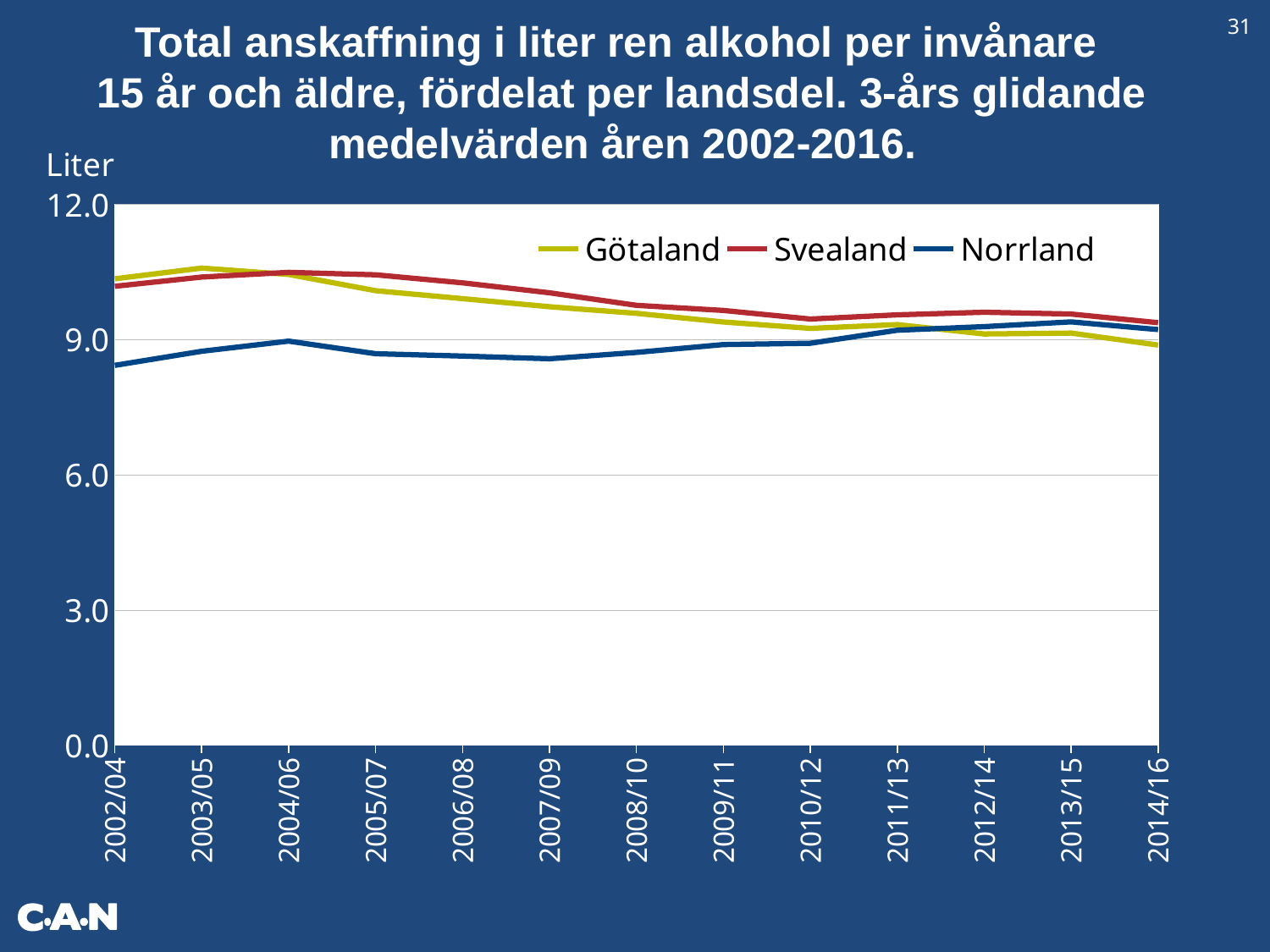
Does the Götaland line generally rise or fall from 2003/05 to 2014/16? fall Is the value for Götaland in 2003/05 greater or less than 9.0? greater What is the label on the y axis? Liter Does the Norrland line generally rise or fall from 2002/04 to 2013/15? rise Which series has the lowest value in 2002/04? Norrland What kind of chart is shown on the slide? line chart How many periods are shown along the x axis? 13 Which is larger in 2007/09, Svealand or Norrland? Svealand How many series does the legend list? 3 Is the value for Svealand in 2004/06 greater or less than 12.0? less Which series are listed in the legend? Götaland, Svealand, Norrland Is the value for Norrland in 2002/04 greater or less than 9.0? less